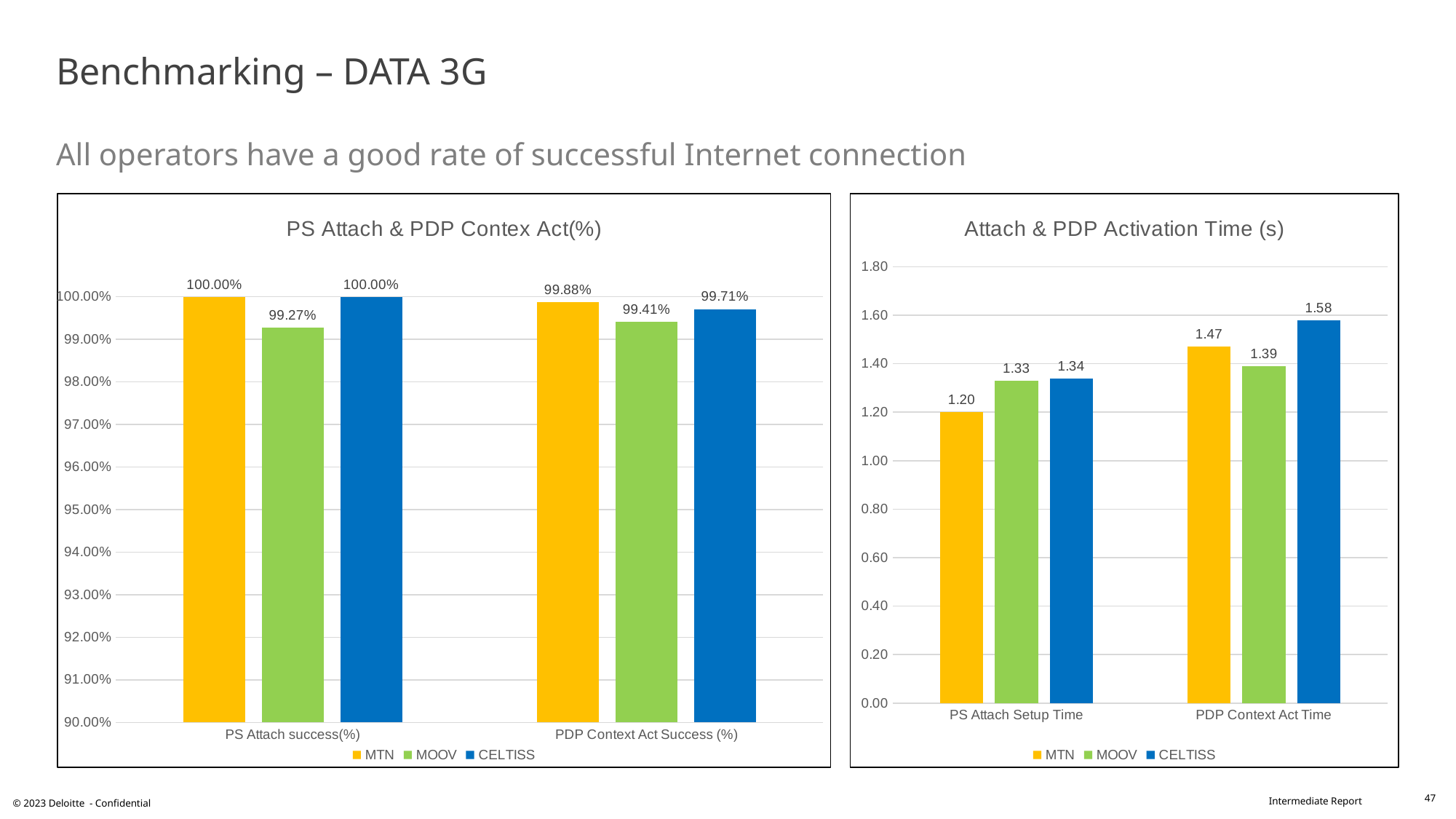
In the 'PS Attach & PDP Contex Act(%)' chart, what is the difference between MTN and MOOV in PDP Context Act Success (%)? 0.47% In the 'PS Attach & PDP Contex Act(%)' chart, what is the value for CELTISS in PDP Context Act Success (%)? 99.71% In the 'Attach & PDP Activation Time (s)' chart, is the PDP Context Act Time for MTN larger or smaller than the PS Attach Setup Time for MTN? larger In the 'PS Attach & PDP Contex Act(%)' chart, what is the value for MOOV in PS Attach success(%)? 99.27% In the 'Attach & PDP Activation Time (s)' chart, what is the PDP Context Act Time for CELTISS? 1.58 In the 'Attach & PDP Activation Time (s)' chart, which operator has the lowest PS Attach Setup Time? MTN What kind of chart is the 'Attach & PDP Activation Time (s)' chart? bar chart In the 'Attach & PDP Activation Time (s)' chart, what is the PS Attach Setup Time for MTN? 1.20 In the 'Attach & PDP Activation Time (s)' chart, what is the difference between CELTISS and MOOV in PDP Context Act Time? 0.19 In the 'PS Attach & PDP Contex Act(%)' chart, how many series does the legend list? 3 In the 'Attach & PDP Activation Time (s)' chart, which operator has the highest PDP Context Act Time? CELTISS In the 'PS Attach & PDP Contex Act(%)' chart, which operator has the lowest PDP Context Act Success (%)? MOOV